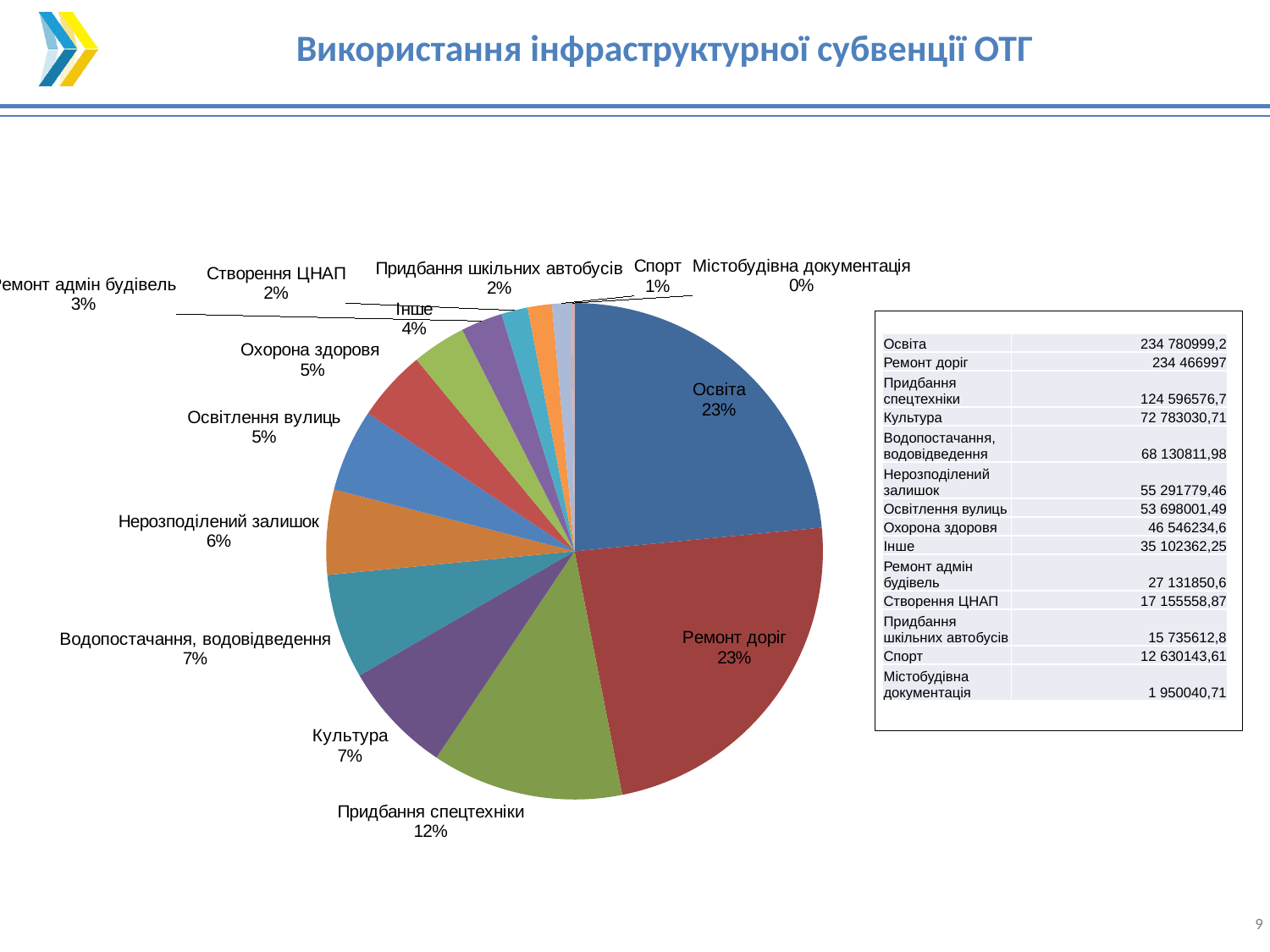
How many categories (slices) does the pie chart have? 14 What share of the pie does Придбання спецтехніки represent? 12% What is the title of the slide containing the pie chart? Використання інфраструктурної субвенції ОТГ What share of the pie does Інше represent? 4% What kind of chart is shown on the slide? pie chart What is the difference in percentage points between the Освіта slice and the Охорона здоровя slice? 18 What share of the pie does Культура represent? 7% According to the table next to the chart, what is the value for Спорт? 12 630143,61 Which category has the smallest slice of the pie? Містобудівна документація Which slice is larger: Придбання спецтехніки or Культура? Придбання спецтехніки